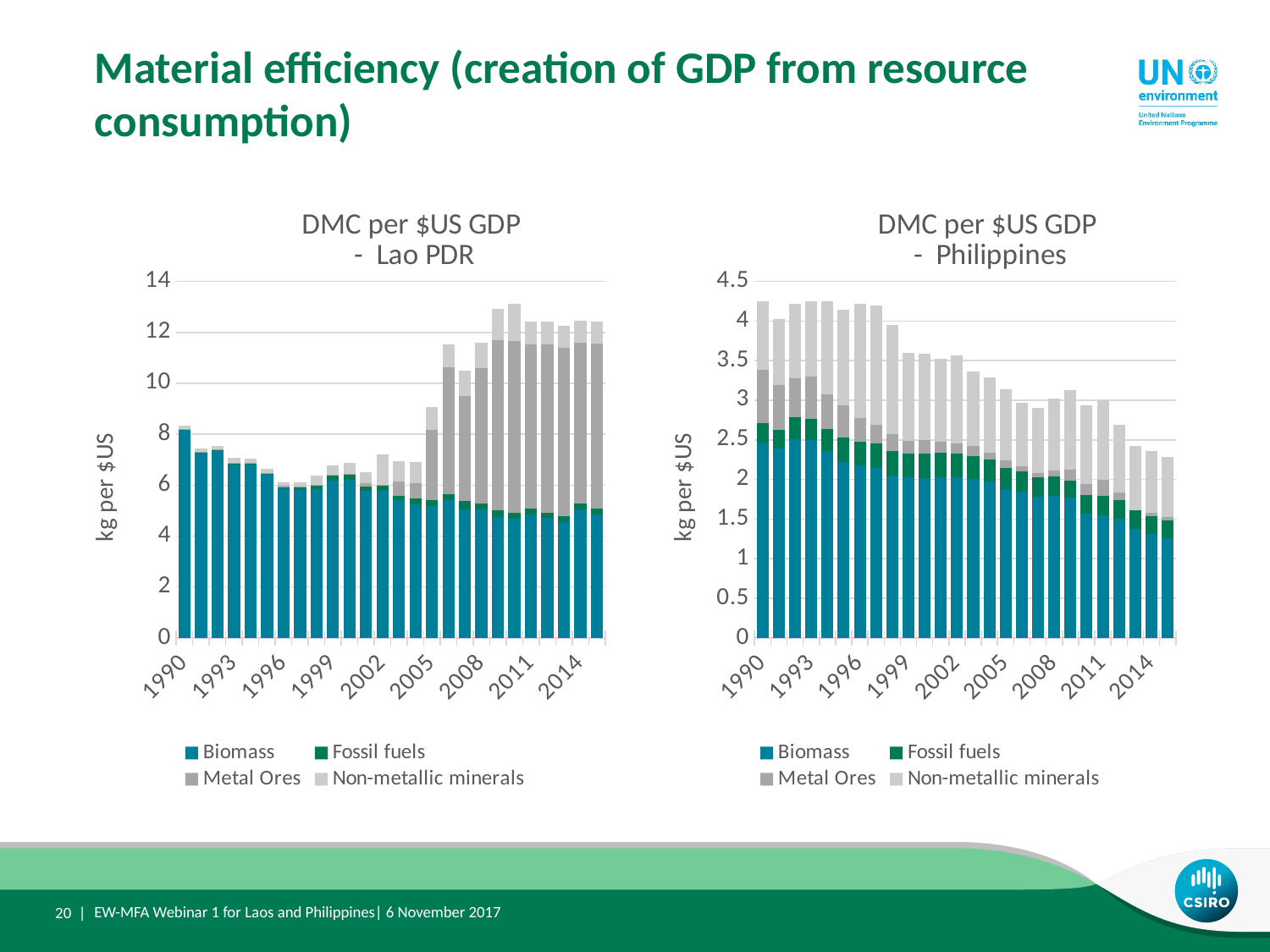
What is the y-axis label on the 'DMC per $US GDP - Lao PDR' chart? kg per $US In the 'DMC per $US GDP - Philippines' chart, which total is larger, 1990 or 2010? 1990 Which series is shown in the lightest grey in the legend of the 'DMC per $US GDP - Philippines' chart? Non-metallic minerals How many series does the legend of the 'DMC per $US GDP - Philippines' chart list? 4 In the 'DMC per $US GDP - Philippines' chart, is the total value for 1990 greater or less than 4? greater In the 'DMC per $US GDP - Lao PDR' chart, which total is larger, 1990 or 2000? 1990 In the 'DMC per $US GDP - Lao PDR' chart, is the total value for 2005 greater or less than 8? greater In the 'DMC per $US GDP - Lao PDR' chart, is the total value for 2010 greater or less than 12? greater In the 'DMC per $US GDP - Philippines' chart, which year has the lowest total bar? 2015 What kind of chart is the 'DMC per $US GDP - Lao PDR' chart? stacked bar chart In the 'DMC per $US GDP - Philippines' chart, do the total bar heights generally rise or fall from 1990 to 2015? fall